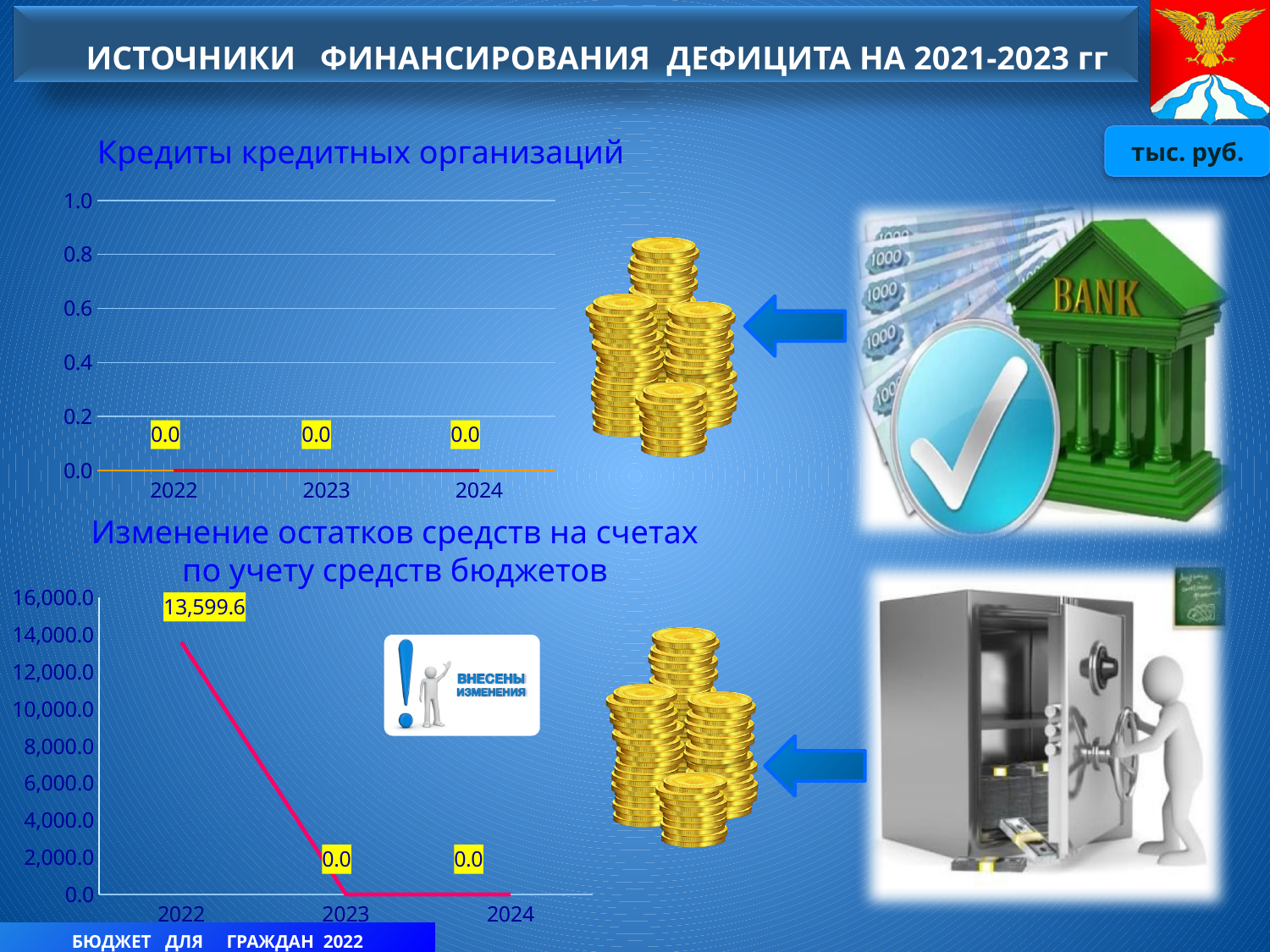
In the chart titled "Изменение остатков средств на счетах по учету средств бюджетов", is the value for 2022 greater or less than 12,000.0? greater What unit of measurement is indicated for the charts on the slide? тыс. руб. In the chart titled "Изменение остатков средств на счетах по учету средств бюджетов", which is larger, the value for 2022 or the value for 2024? 2022 What kind of chart is the one titled "Изменение остатков средств на счетах по учету средств бюджетов"? line chart In the chart titled "Изменение остатков средств на счетах по учету средств бюджетов", what is the difference between the 2022 value and the 2023 value? 13,599.6 In the chart titled "Кредиты кредитных организаций", what is the value for 2023? 0.0 In the chart titled "Изменение остатков средств на счетах по учету средств бюджетов", what is the value for 2022? 13,599.6 What kind of chart is the one titled "Кредиты кредитных организаций"? line chart In the chart titled "Изменение остатков средств на счетах по учету средств бюджетов", which year has the highest value? 2022 In the chart titled "Изменение остатков средств на счетах по учету средств бюджетов", do the values rise or fall from 2022 to 2023? fall In the chart titled "Кредиты кредитных организаций", how many years are plotted on the x axis? 3 In the chart titled "Изменение остатков средств на счетах по учету средств бюджетов", what is the value for 2024? 0.0